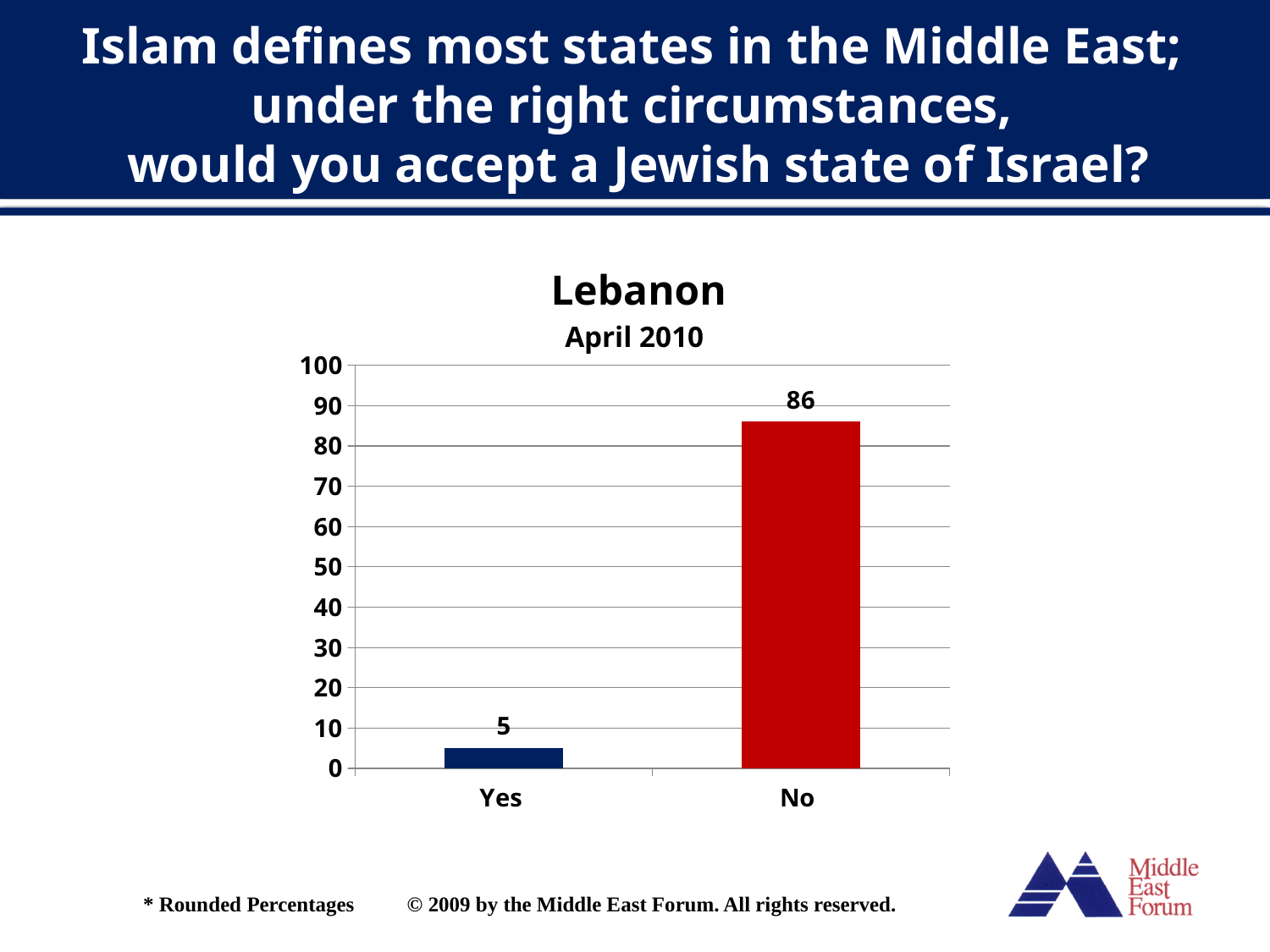
What is the title of the chart? Lebanon What is the value for "Yes"? 5 What is the difference between the values for "No" and "Yes"? 81 Which category has the lowest value? Yes Which is larger, the value for "Yes" or the value for "No"? No How many categories are shown on the x axis? 2 Is the value for "No" greater or less than 80? greater Is the value for "Yes" greater or less than 10? less What kind of chart is shown on the slide? bar chart Which category has the highest value? No What date is shown in the chart's subtitle? April 2010 What is the value for "No"? 86